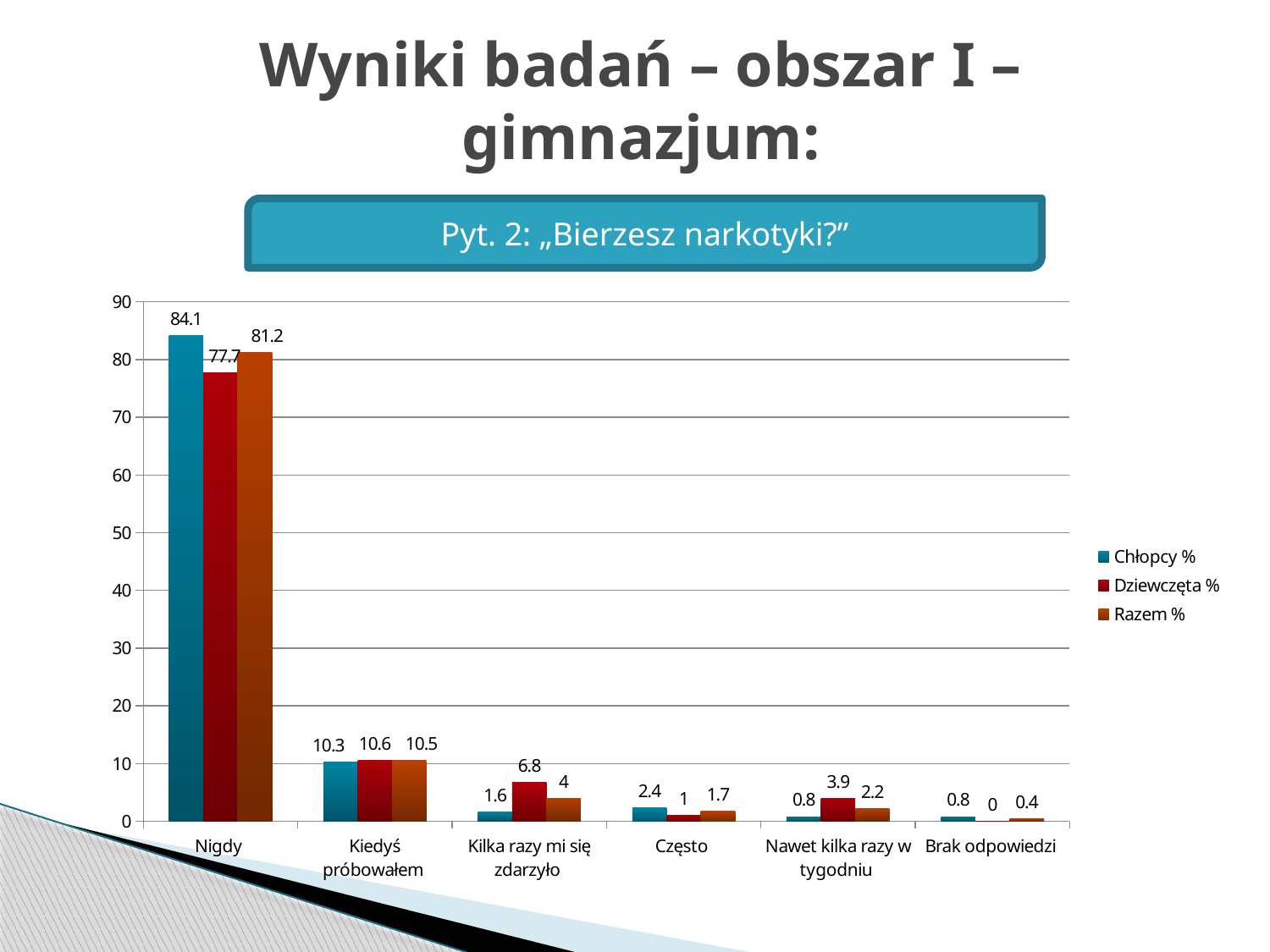
What question is the chart about, as shown in the box above it? Pyt. 2: „Bierzesz narkotyki?” What is the value for Dziewczęta % in the Kilka razy mi się zdarzyło category? 6.8 How many series does the legend list? 3 Which category has the highest value for Razem %? Nigdy What is the value for Razem % in the Brak odpowiedzi category? 0.4 Is the value for Razem % in the Nigdy category greater or less than 80? greater How many categories are shown on the x axis? 6 Which is larger in the Często category: Chłopcy % or Dziewczęta %? Chłopcy % What kind of chart is shown on the slide? bar chart Which category has the lowest value for Dziewczęta %? Brak odpowiedzi What is the difference between Chłopcy % and Dziewczęta % in the Nigdy category? 6.4 What is the value for Chłopcy % in the Nigdy category? 84.1